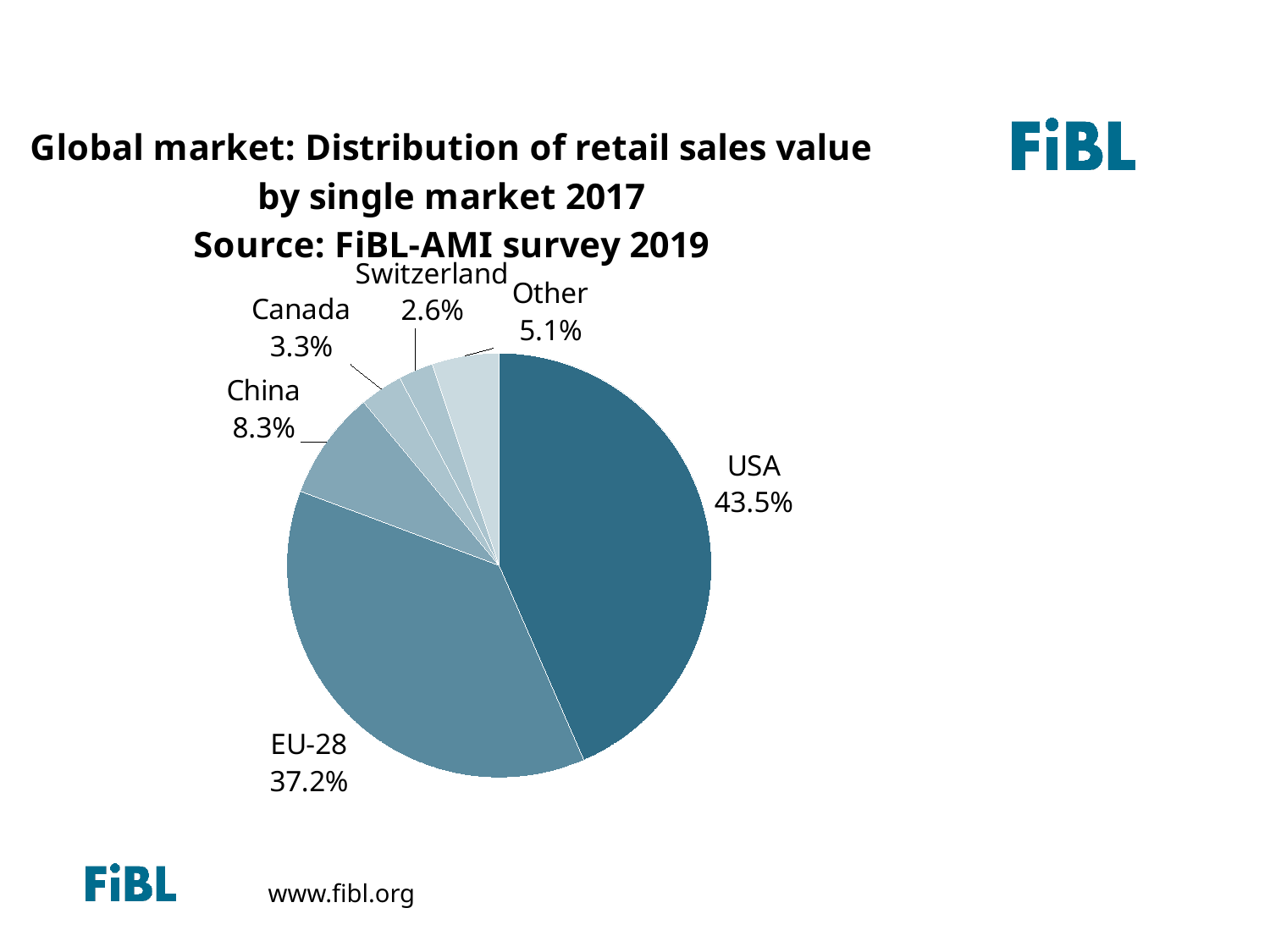
What is the difference in percentage points between the USA and EU-28 shares? 6.3 Which is larger, the share for Canada or the share for Other? Other What is the share labelled for Switzerland? 2.6% What share of retail sales value does the USA hold in the pie chart? 43.5% Which named slice has the smallest share? Switzerland How many slices does the pie chart have? 6 According to the chart title, which survey is the source of the data? FiBL-AMI survey 2019 What is the share for EU-28? 37.2% What type of chart is shown on the slide? Pie chart What percentage is shown for China? 8.3% Which market has the largest slice of the pie? USA What is the combined share of the USA and EU-28? 80.7%